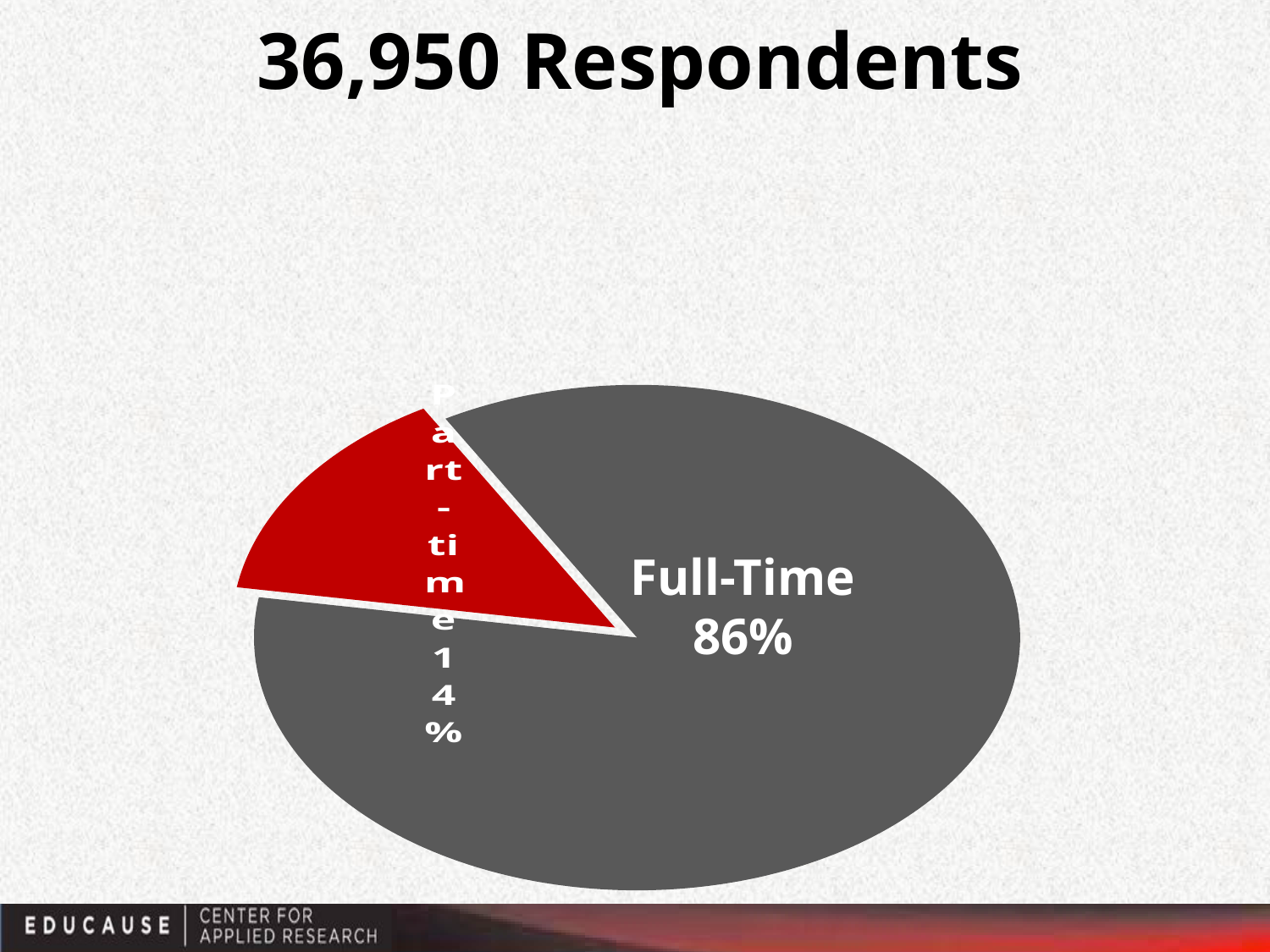
How many slices does the pie chart have? 2 What kind of chart is shown on the slide? pie chart What share of respondents are Full-Time? 86% What share of respondents are Part-time? 14% What is the difference in percentage points between the Full-Time and Part-time slices? 72 Which category has the smallest slice of the pie? Part-time What colour is the Part-time slice? red Which is larger, the Full-Time slice or the Part-time slice? Full-Time Which category has the largest slice of the pie? Full-Time What is the title of the slide above the pie chart? 36,950 Respondents What is the total of the two slice percentages shown? 100%